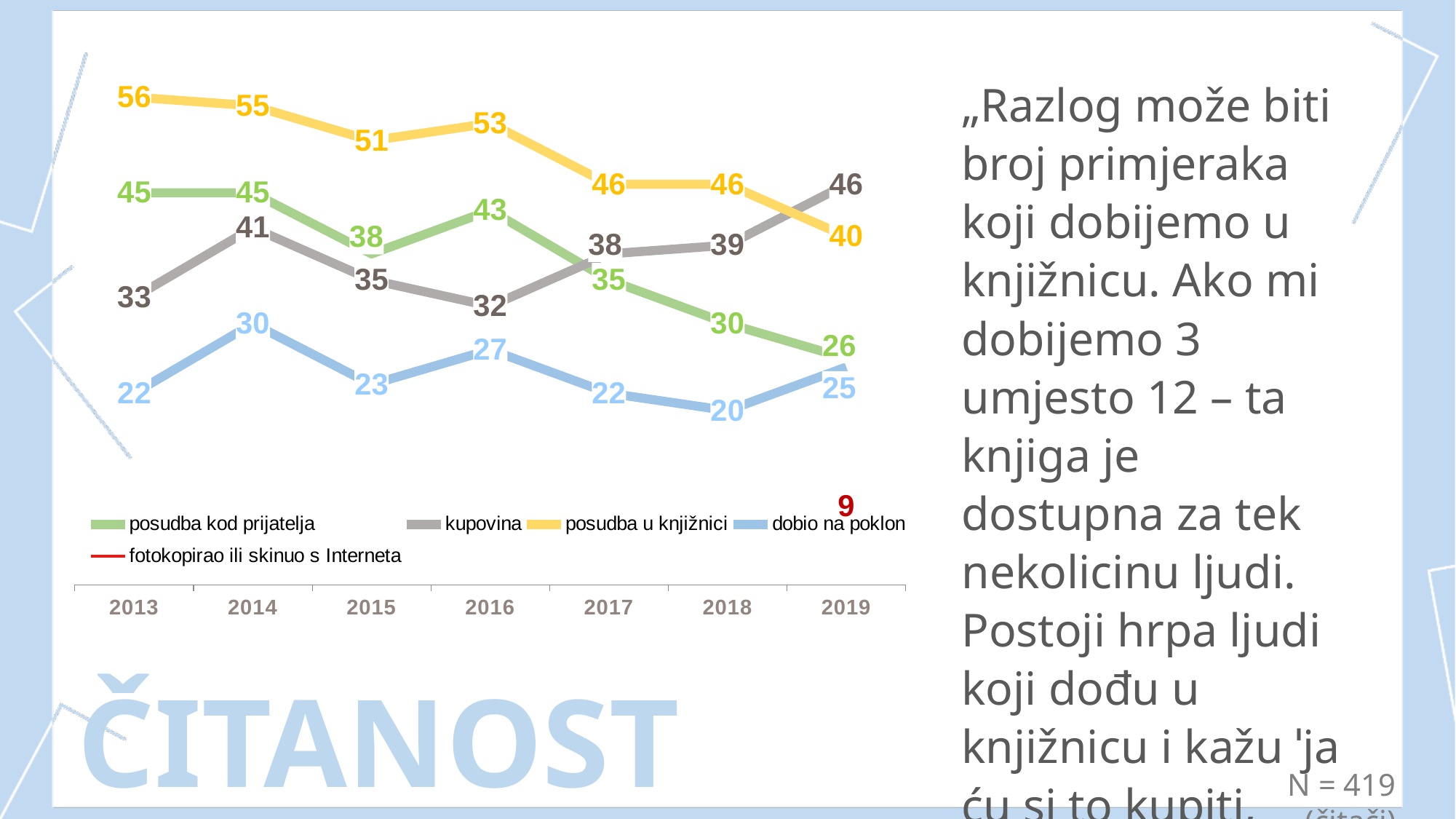
In which year is 'posudba kod prijatelja' lowest? 2019 Which is larger in 2019, 'kupovina' or 'posudba u knjižnici'? kupovina What is the difference between 'posudba u knjižnici' in 2013 and in 2019? 16 In which year is 'kupovina' highest? 2019 What is the value for 'dobio na poklon' in 2018? 20 What is the value for 'fotokopirao ili skinuo s Interneta' in 2019? 9 How many years are shown on the x axis? 7 What type of chart is shown on the slide? line chart Does 'posudba kod prijatelja' rise or fall from 2016 to 2019? fall What is the value for 'kupovina' in 2019? 46 How many series does the legend list? 5 What is the value for 'posudba u knjižnici' in 2013? 56